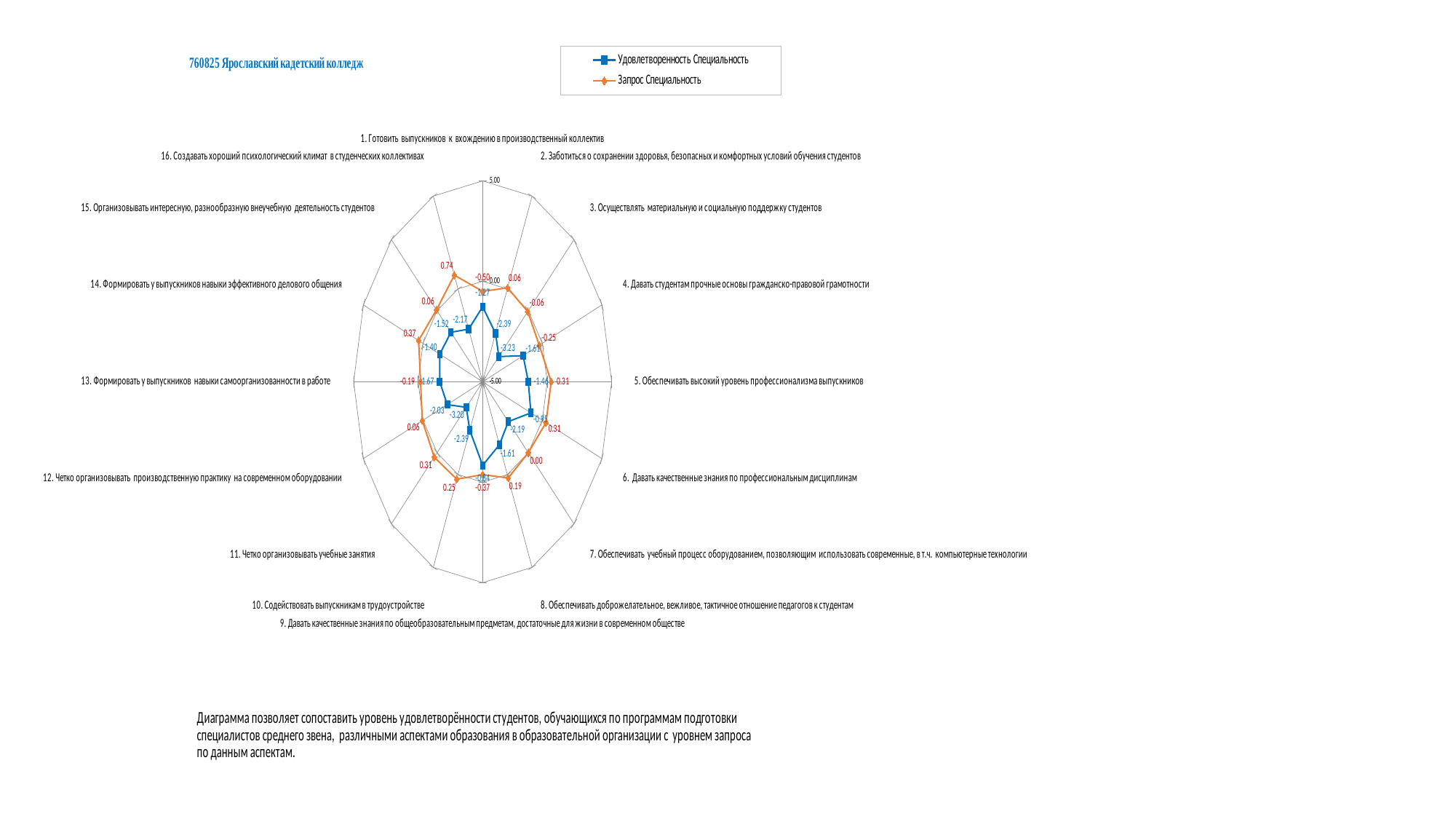
How many categories (axes) does the radar chart have? 16 For category 5, which series has the larger value: 'Удовлетворенность Специальность' or 'Запрос Специальность'? Запрос Специальность What is the maximum value shown on the radial axis of the chart? 5.00 What type of chart is shown on the slide? Radar chart What is the value of 'Удовлетворенность Специальность' for category 5 (Обеспечивать высокий уровень профессионализма выпускников)? -1.46 What is the value of 'Запрос Специальность' for category 13 (Формировать у выпускников навыки самоорганизованности в работе)? -0.19 For which category does 'Запрос Специальность' reach its highest value? 16. Создавать хороший психологический климат в студенческих коллективах (0.74) What is the value of 'Удовлетворенность Специальность' for category 13 (Формировать у выпускников навыки самоорганизованности в работе)? -1.67 What is the difference between 'Запрос Специальность' and 'Удовлетворенность Специальность' for category 5? 1.77 What is the value of 'Запрос Специальность' for category 5 (Обеспечивать высокий уровень профессионализма выпускников)? 0.31 What are the two series named in the legend? Удовлетворенность Специальность; Запрос Специальность How many series does the legend list? 2